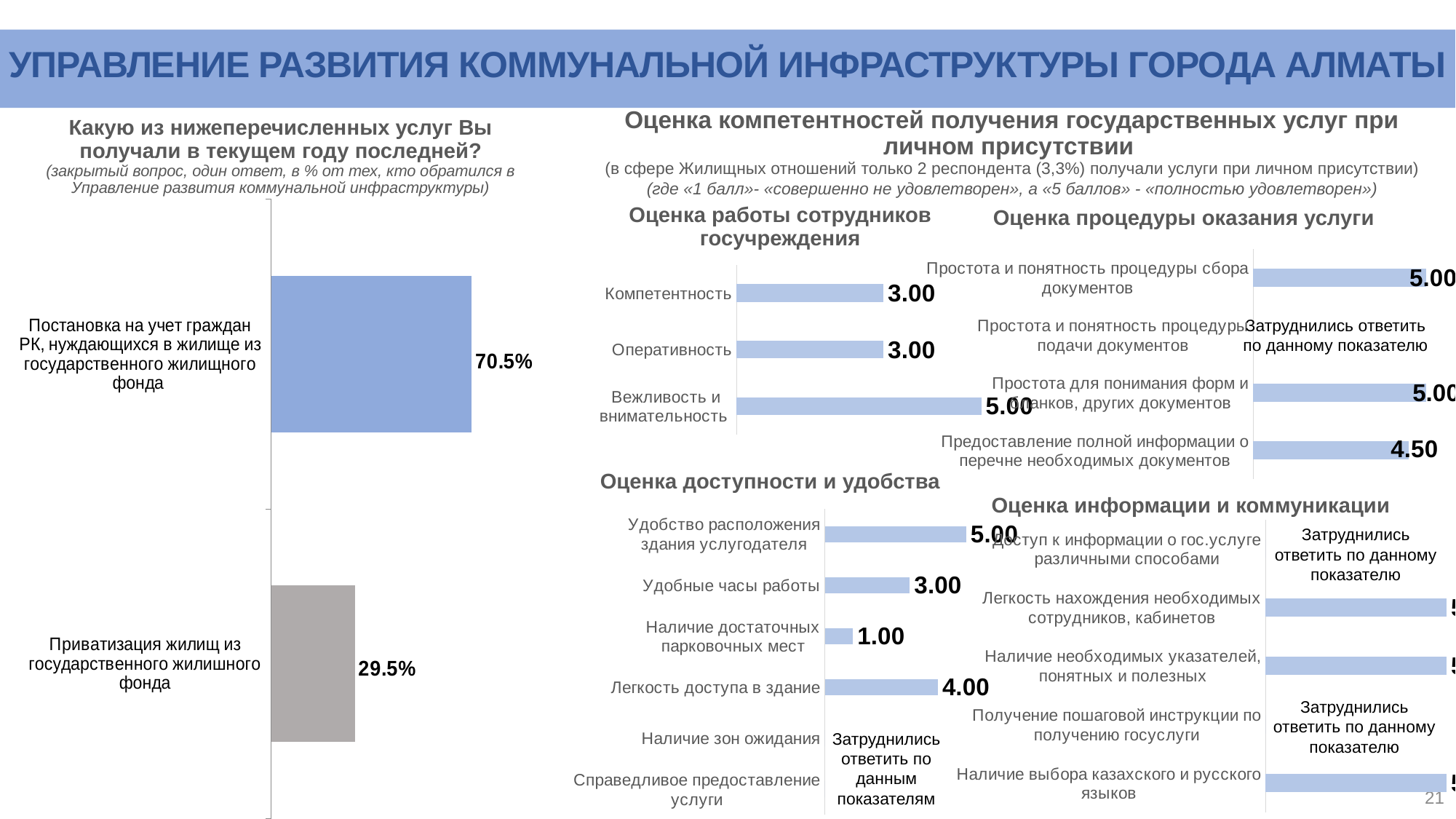
In the chart 'Оценка доступности и удобства', what is the difference between 'Удобство расположения здания услугодателя' and 'Наличие достаточных парковочных мест'? 4.00 In the chart 'Оценка работы сотрудников госучреждения', which category has the highest value? Вежливость и внимательность In the chart 'Оценка доступности и удобства', what is the value for 'Наличие достаточных парковочных мест'? 1.00 In the chart 'Какую из нижеперечисленных услуг Вы получали в текущем году последней?', what is the value for 'Приватизация жилищ из государственного жилишного фонда'? 29.5% In the chart 'Оценка процедуры оказания услуги', which category has the lowest plotted value? Предоставление полной информации о перечне необходимых документов What type of chart is 'Какую из нижеперечисленных услуг Вы получали в текущем году последней?'? Bar chart In the chart 'Какую из нижеперечисленных услуг Вы получали в текущем году последней?', what is the difference between the two values? 41.0 percentage points In the chart 'Оценка работы сотрудников госучреждения', what is the value for 'Вежливость и внимательность'? 5.00 In the chart 'Оценка доступности и удобства', which is larger: 'Удобные часы работы' or 'Легкость доступа в здание'? Легкость доступа в здание In the chart 'Оценка работы сотрудников госучреждения', how many categories are shown? 3 In the chart 'Оценка процедуры оказания услуги', what is the value for 'Предоставление полной информации о перечне необходимых документов'? 4.50 In the chart 'Какую из нижеперечисленных услуг Вы получали в текущем году последней?', what is the value for 'Постановка на учет граждан РК, нуждающихся в жилище из государственного жилищного фонда'? 70.5%